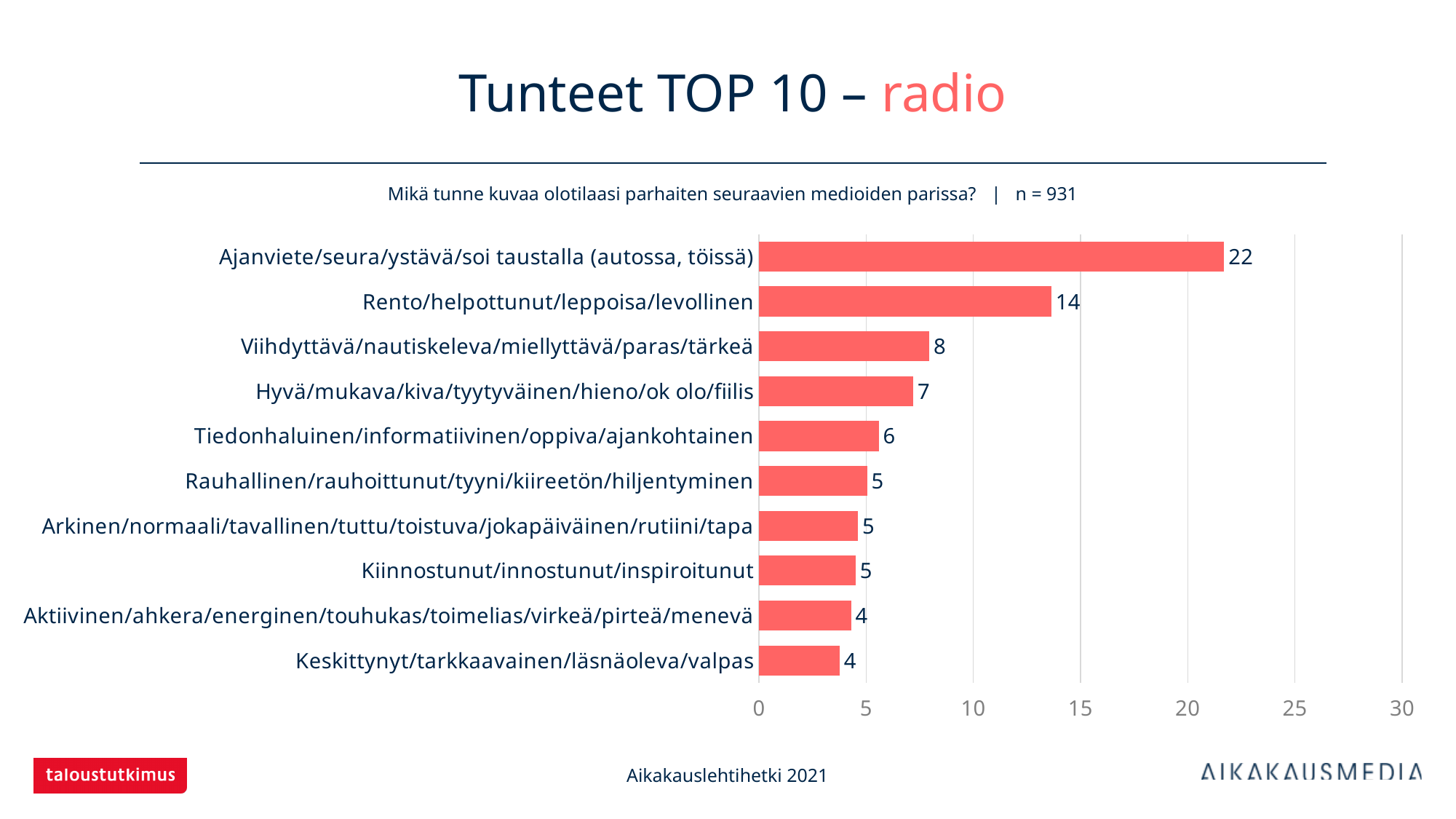
What is the title of the chart on the slide? Tunteet TOP 10 – radio What kind of chart is shown on the slide? bar chart Is the value for Ajanviete/seura/ystävä/soi taustalla (autossa, töissä) greater or less than 20? greater What is the value for Tiedonhaluinen/informatiivinen/oppiva/ajankohtainen? 6 What is the difference between the values for Ajanviete/seura/ystävä/soi taustalla (autossa, töissä) and Rento/helpottunut/leppoisa/levollinen? 8 What is the value for Keskittynyt/tarkkaavainen/läsnäoleva/valpas? 4 Which is larger, the value for Rento/helpottunut/leppoisa/levollinen or the value for Viihdyttävä/nautiskeleva/miellyttävä/paras/tärkeä? Rento/helpottunut/leppoisa/levollinen What is the value for Rento/helpottunut/leppoisa/levollinen? 14 What is the difference between the values for Viihdyttävä/nautiskeleva/miellyttävä/paras/tärkeä and Hyvä/mukava/kiva/tyytyväinen/hieno/ok olo/fiilis? 1 What is the value for Ajanviete/seura/ystävä/soi taustalla (autossa, töissä)? 22 How many categories are shown in the chart? 10 Which category has the highest value? Ajanviete/seura/ystävä/soi taustalla (autossa, töissä)